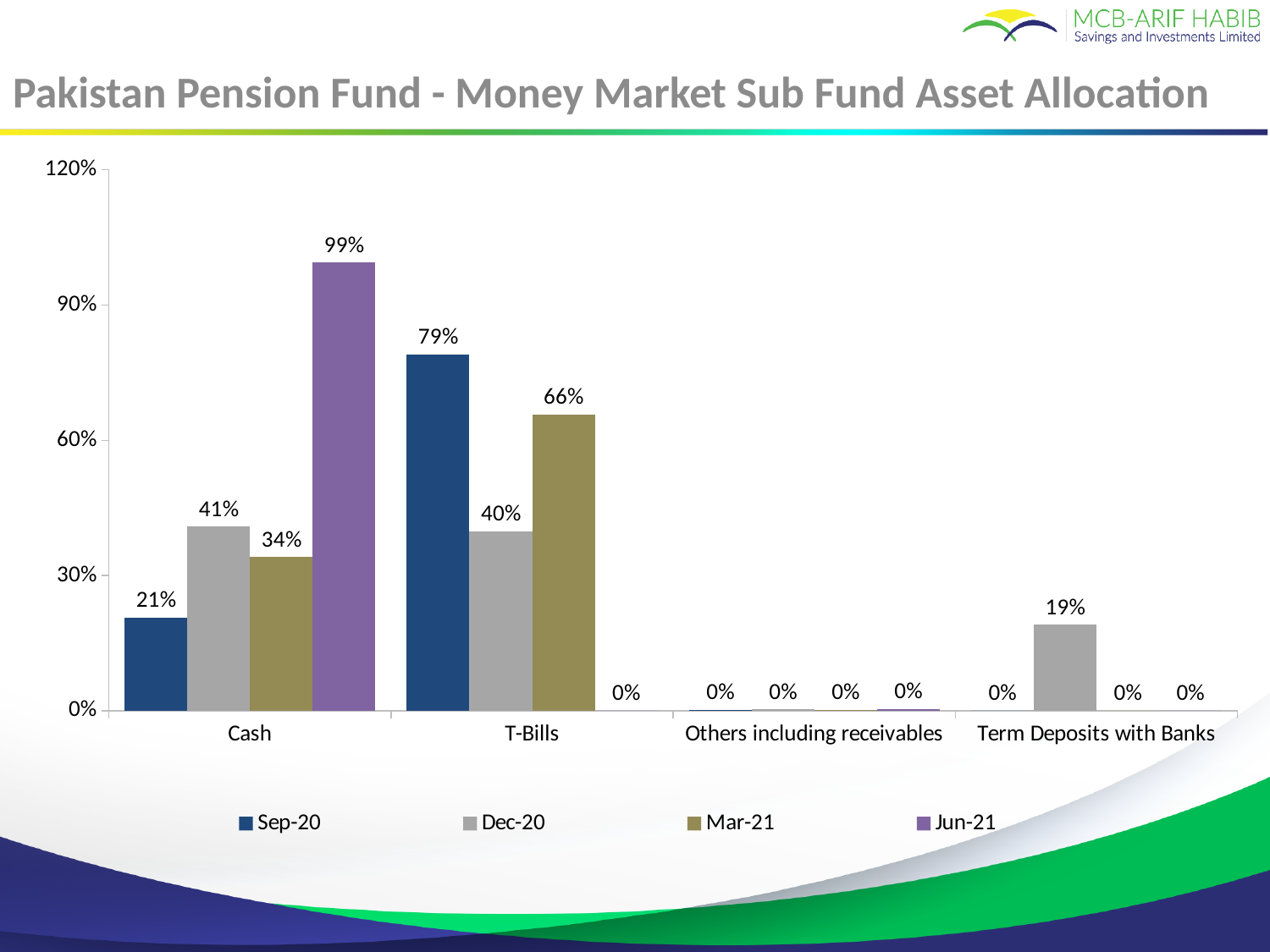
What kind of chart is shown on the slide? Bar chart What is the difference between the Mar-21 value for T-Bills and the Mar-21 value for Cash? 32% What is the Sep-20 value for T-Bills? 79% What is the Mar-21 value for Cash? 34% How many series does the legend list? 4 Is the Sep-20 value for T-Bills greater or less than 60%? greater What is the Jun-21 value for Cash? 99% Which category has the highest Sep-20 value? T-Bills Which is larger: the Dec-20 value for Cash or the Dec-20 value for T-Bills? Cash How many categories are shown on the x axis? 4 Which category has the highest Jun-21 value? Cash What is the Dec-20 value for Term Deposits with Banks? 19%